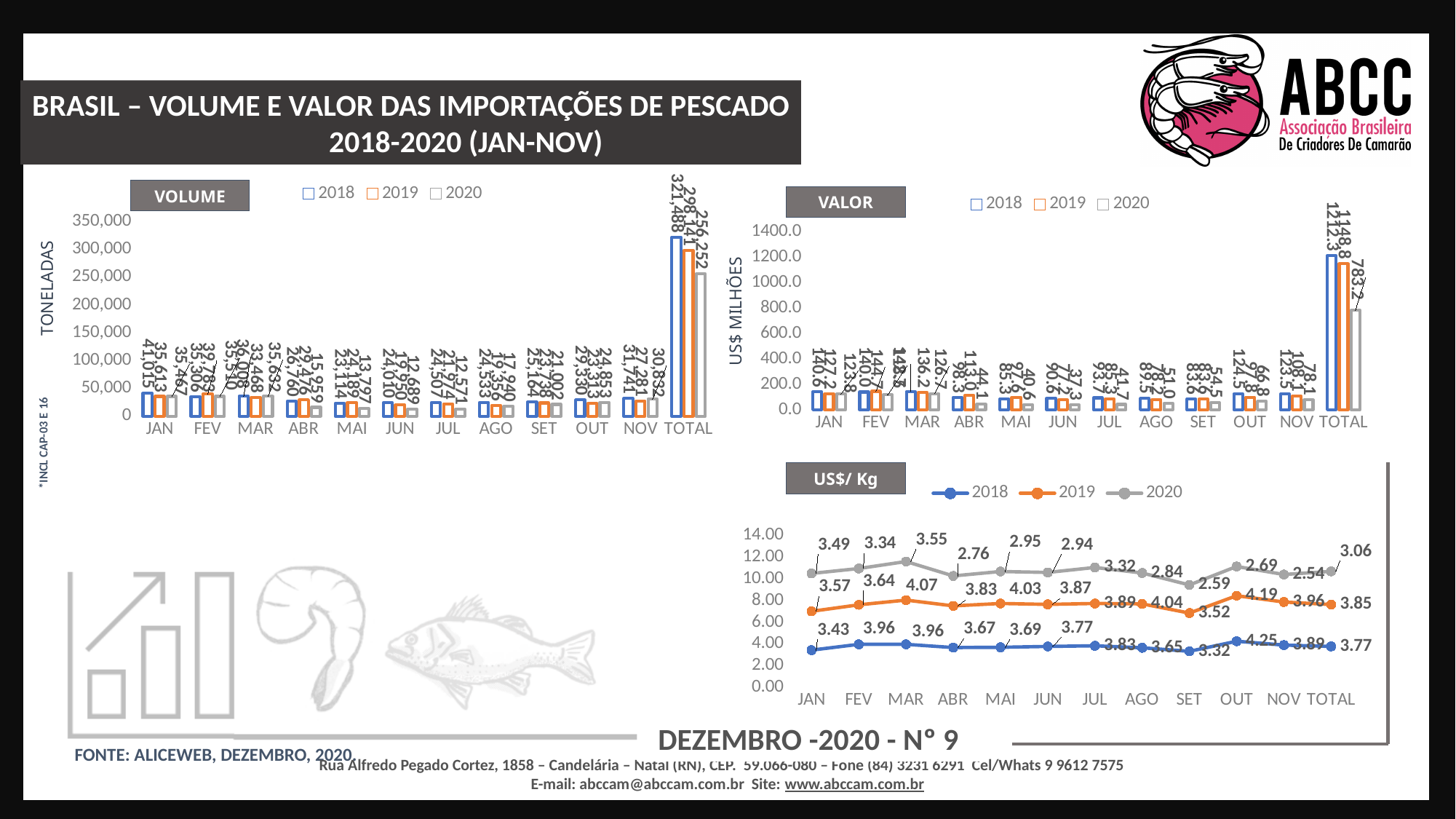
How many series does the legend of the US$/ Kg chart list? 3 In the VALOR chart, what is the difference between the TOTAL values for 2018 and 2019? 63.5 In the US$/ Kg chart, what is the 2019 value for OUT? 4.19 In the VOLUME chart, what is the TOTAL value for 2018? 321,488 In the VOLUME chart, what is the difference between the TOTAL values for 2018 and 2020? 65,236 What kind of chart is the US$/ Kg chart? line chart In the VOLUME chart, what is the TOTAL value for 2020? 256,252 In the US$/ Kg chart, which month has the lowest 2020 value? NOV What kind of chart is the VOLUME chart? bar chart In the US$/ Kg chart, which month has the highest 2020 value? MAR In the VALOR chart, what is the TOTAL value for 2020? 783.2 In the VOLUME chart, which TOTAL is larger, 2019 or 2020? 2019